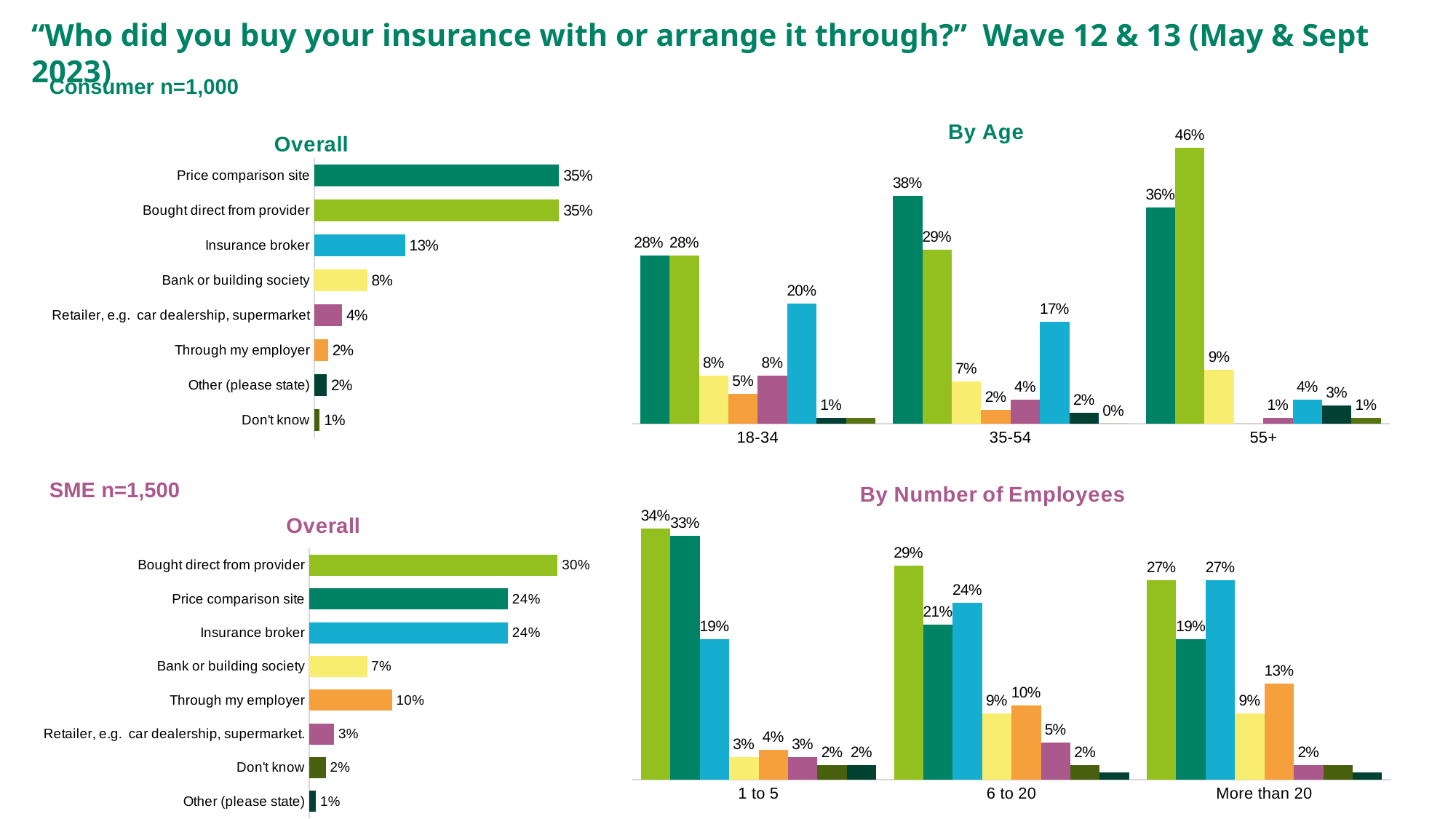
In the SME Overall chart, which category has the highest value? Bought direct from provider How many categories are shown in the Consumer Overall chart? 8 In the Consumer Overall chart, which category has the lowest value? Don't know In the Consumer Overall chart, what is the value for Bank or building society? 8% In the Consumer Overall chart, what is the difference between Insurance broker and Bank or building society? 5 percentage points In the SME Overall chart, what is the value for Through my employer? 10% In the By Number of Employees chart, what is the value of the tallest bar in the 6 to 20 group? 29% In the By Age chart, what is the highest value shown for the 55+ group? 46% In the Consumer Overall chart, what is the value for Insurance broker? 13% In the SME Overall chart, which is larger: Through my employer or Bank or building society? Through my employer How many age groups are shown on the x axis of the By Age chart? 3 What type of chart is the SME Overall chart? Bar chart